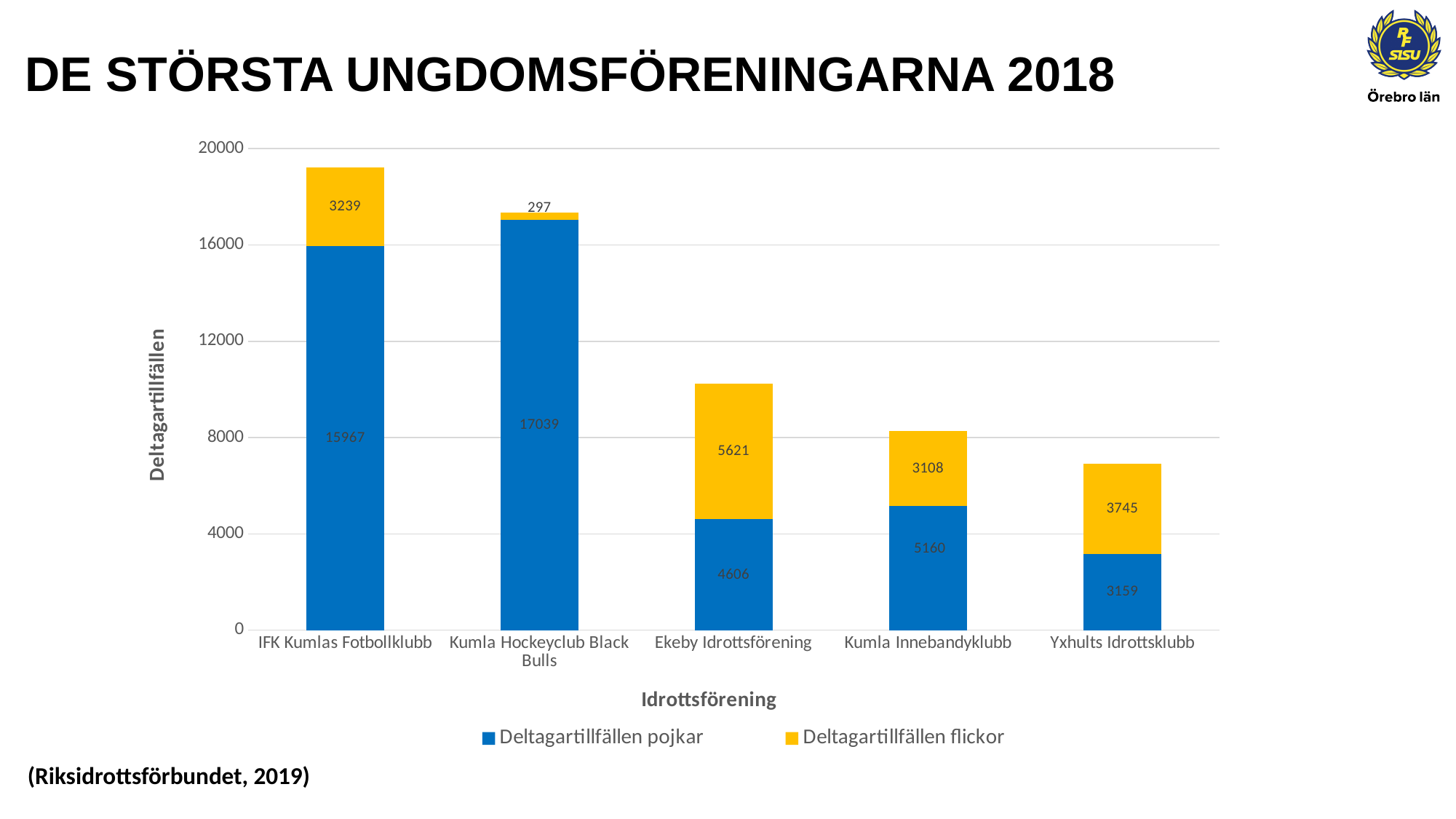
What is the difference between Deltagartillfällen pojkar and Deltagartillfällen flickor for Yxhults Idrottsklubb? 586 What is the value of Deltagartillfällen flickor for Ekeby Idrottsförening? 5621 What is the total of the stacked bar for Kumla Innebandyklubb? 8268 What is the total of the stacked bar for IFK Kumlas Fotbollklubb? 19206 Which is larger for Ekeby Idrottsförening: Deltagartillfällen pojkar or Deltagartillfällen flickor? Deltagartillfällen flickor What is the value of Deltagartillfällen flickor for Kumla Hockeyclub Black Bulls? 297 How many associations are shown on the x axis? 5 Which association has the highest value for Deltagartillfällen pojkar? Kumla Hockeyclub Black Bulls What is the value of Deltagartillfällen pojkar for IFK Kumlas Fotbollklubb? 15967 Which association has the lowest value for Deltagartillfällen flickor? Kumla Hockeyclub Black Bulls What kind of chart is shown on the slide? Stacked bar chart How many series does the legend list? 2